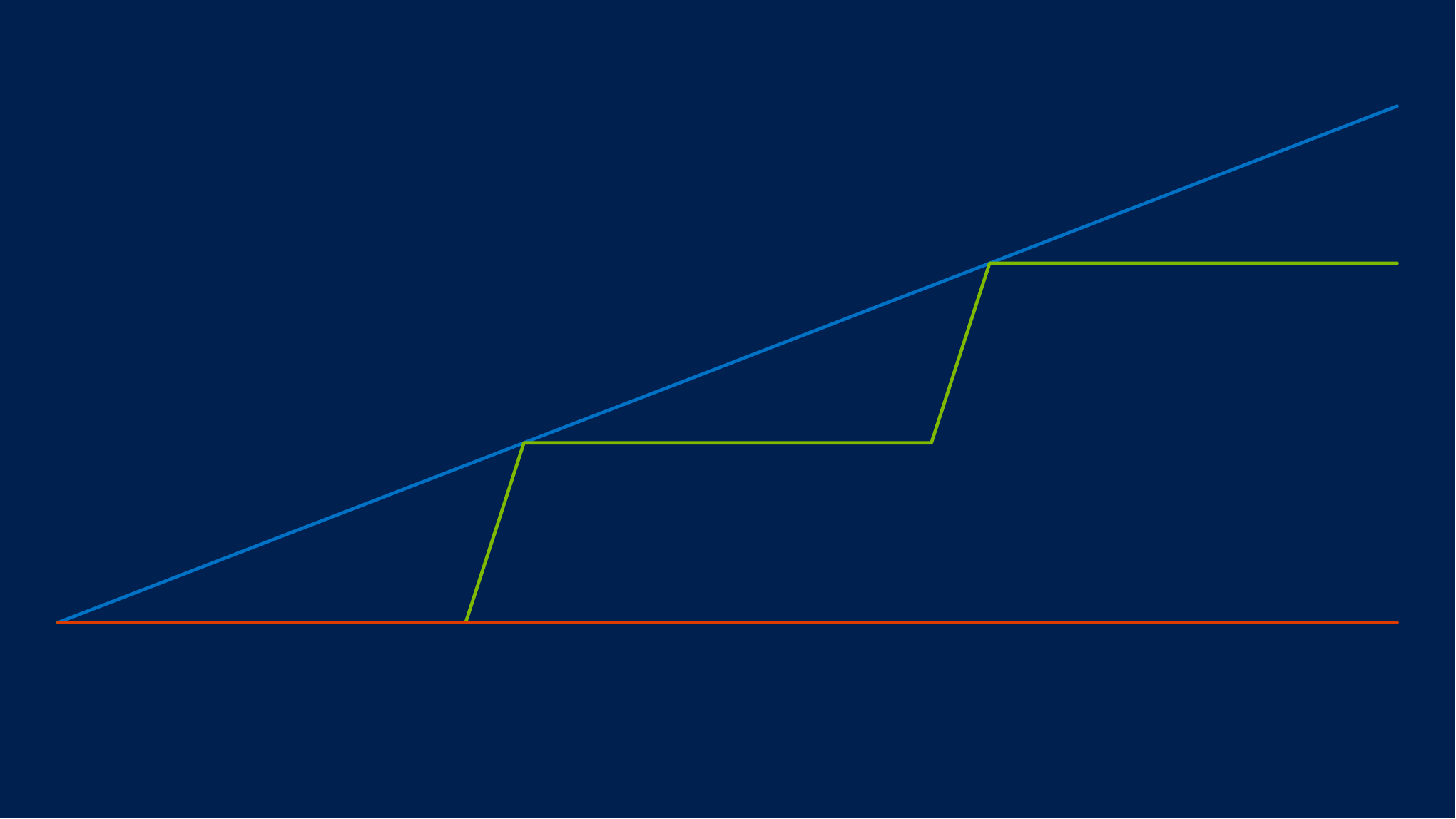
What kind of chart is shown on the slide? line chart At the right edge of the chart, which line is higher, the green line or the red line? the green line Which line is the lowest across the whole chart? the red line Which line has a step-like shape with flat sections and steep rises? the green line Does the green line end higher or lower than it starts? higher At the right edge of the chart, which line is higher, the blue line or the green line? the blue line How many lines are plotted on the chart? 3 Does the red line rise, fall, or stay flat from left to right? stays flat Does the blue line rise or fall from left to right? rises